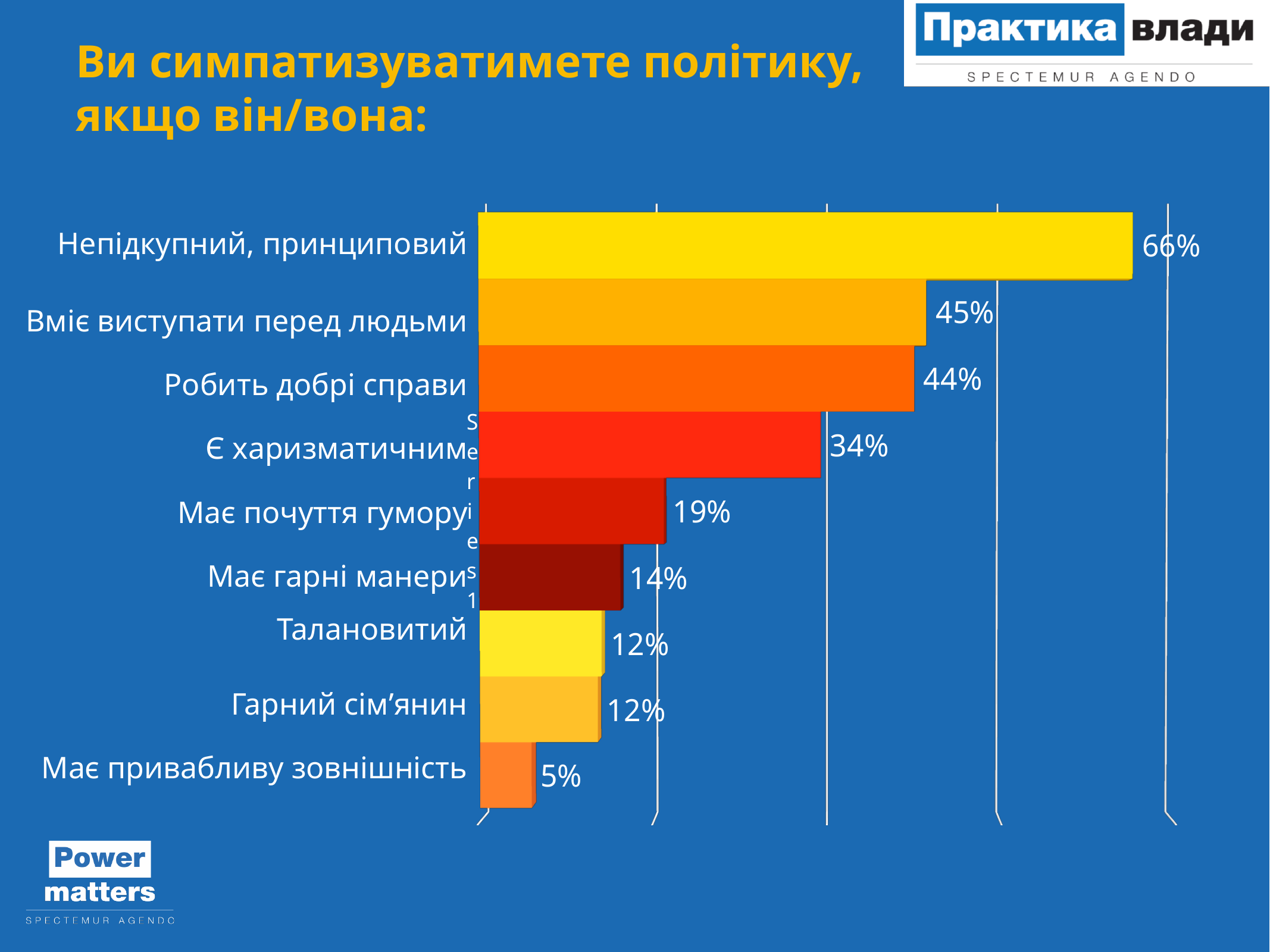
What is the value for "Має привабливу зовнішність"? 5% What type of chart is shown on the slide? bar chart Which category has the lowest value? Має привабливу зовнішність What is the value for "Є харизматичним"? 34% Which category has the highest value? Непідкупний, принциповий How many categories are shown in the chart? 9 What is the difference between the values for "Є харизматичним" and "Має почуття гумору"? 15% Which is larger, the value for "Робить добрі справи" or the value for "Має почуття гумору"? Робить добрі справи What is the value for "Має гарні манери"? 14% What is the title of the slide containing the chart? Ви симпатизуватимете політику, якщо він/вона: What percentage is shown for "Непідкупний, принциповий"? 66% What is the difference between the values for "Непідкупний, принциповий" and "Вміє виступати перед людьми"? 21%